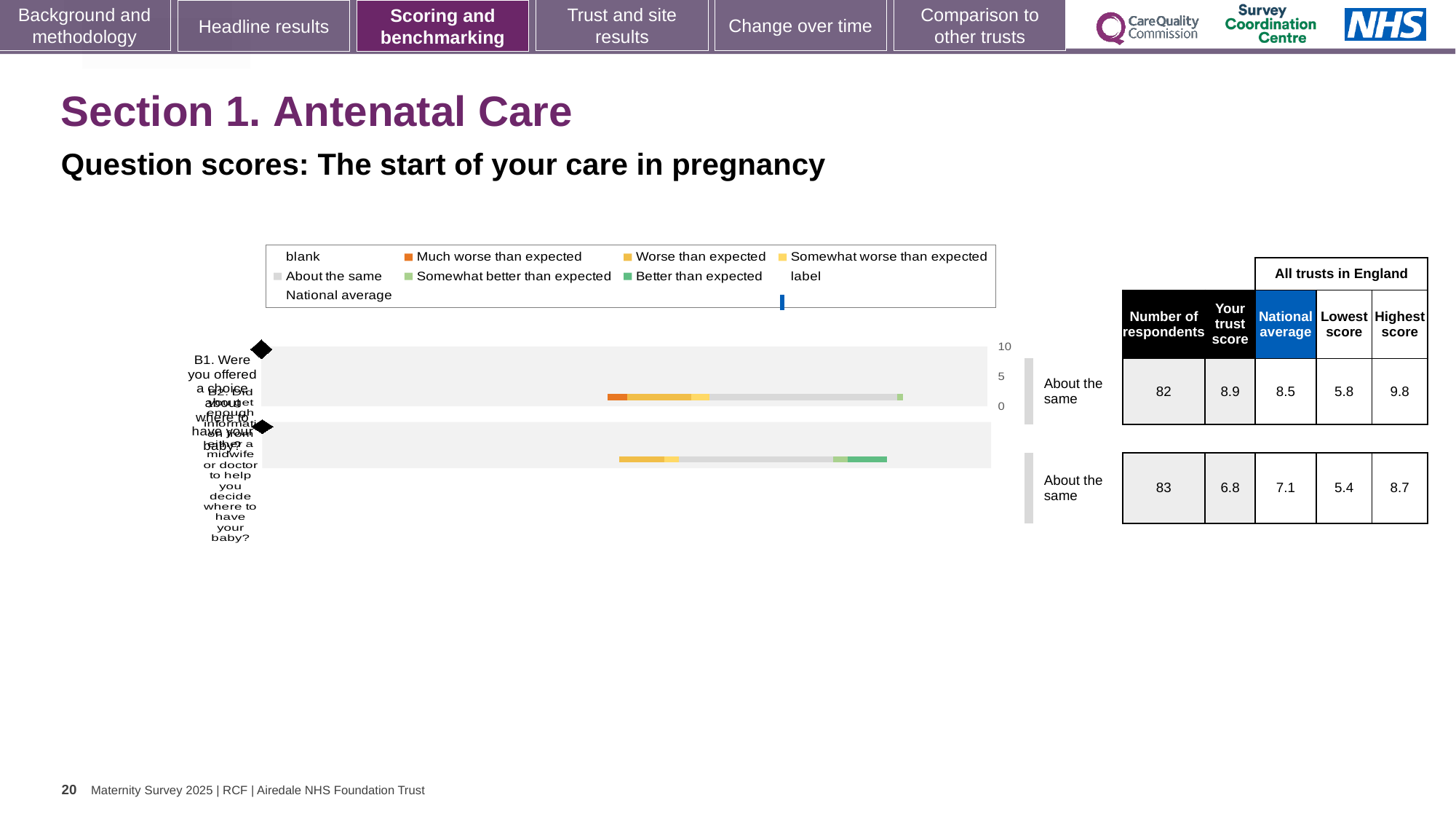
What colour does the legend use for 'Much worse than expected'? orange In the table next to the chart, what is the number of respondents for question B2? 83 How many questions (categories) are plotted on the chart? 2 What kind of chart is shown on the slide? bar chart Which question has the higher 'Your trust score', B1 or B2? B1 What is the highest score among all trusts in England for question B1? 9.8 In the table next to the chart, what is the 'Your trust score' for question B1 (Were you offered a choice about where to have your baby?)? 8.9 What is the highest tick value shown on the chart's axis? 10 How many entries does the chart legend list? 9 In the table next to the chart, what is the 'Your trust score' for question B2 (Did you get enough information from either a midwife or doctor to help you decide where to have your baby?)? 6.8 In the table next to the chart, what is the national average for question B1? 8.5 What is the difference between the 'Your trust score' for B1 (8.9) and for B2 (6.8)? 2.1